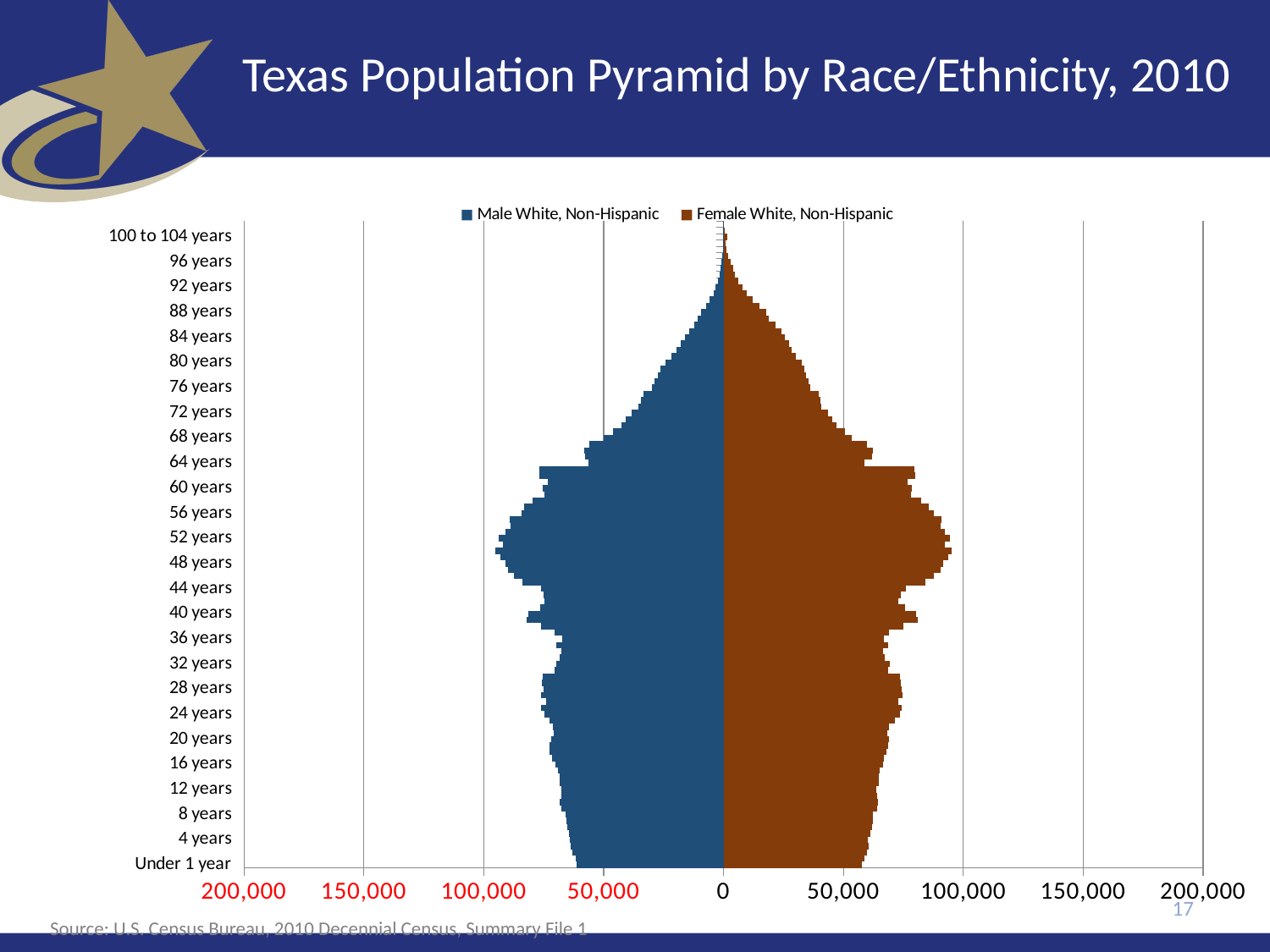
Which is larger for Male White, Non-Hispanic: the value at 48 years or the value at 88 years? 48 years Is the value for Male White, Non-Hispanic at 88 years greater or less than 50,000? less What is the largest value shown on the horizontal axis? 200,000 Is the value for Male White, Non-Hispanic at 48 years greater or less than 150,000? less What kind of chart is shown on the slide? Bar chart (population pyramid) What is the title of the chart? Texas Population Pyramid by Race/Ethnicity, 2010 How many series does the legend list? 2 Is the value for Female White, Non-Hispanic at 48 years greater or less than 50,000? greater What are the two series named in the legend? Male White, Non-Hispanic and Female White, Non-Hispanic Which is larger for Female White, Non-Hispanic: the value at 64 years or the value at 84 years? 64 years